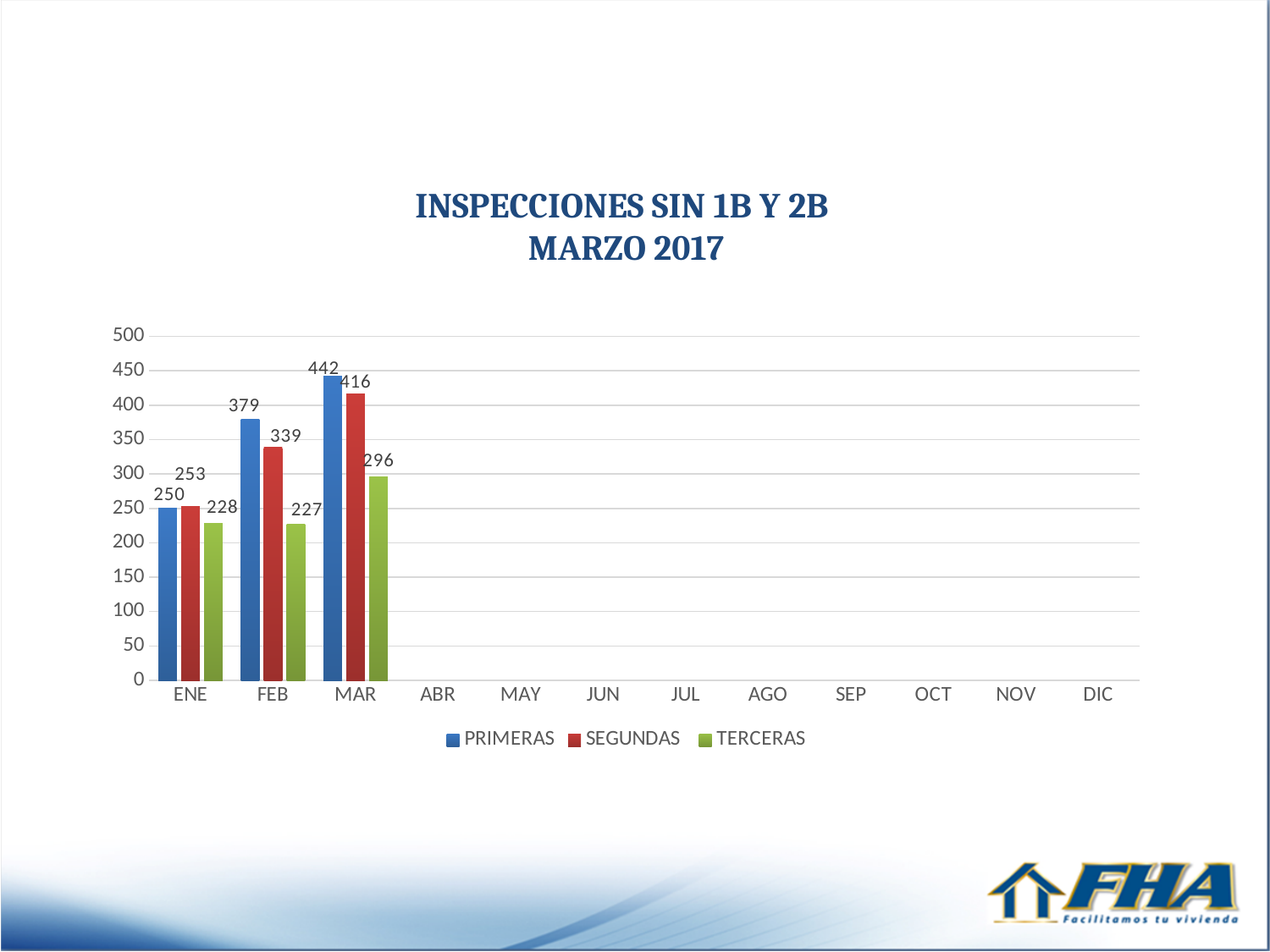
How many series does the legend list? 3 What is the value for SEGUNDAS in FEB? 339 What is the value for TERCERAS in MAR? 296 What is the value for PRIMERAS in ENE? 250 How many months are shown on the x axis? 12 What is the difference between PRIMERAS and SEGUNDAS in MAR? 26 Do the SEGUNDAS values rise or fall from ENE to MAR? rise Which month has the lowest value for TERCERAS? FEB Which is larger in ENE, SEGUNDAS or TERCERAS? SEGUNDAS Which month has the highest value for PRIMERAS? MAR What kind of chart is shown? bar chart Is the value for PRIMERAS in FEB greater or less than 350? greater